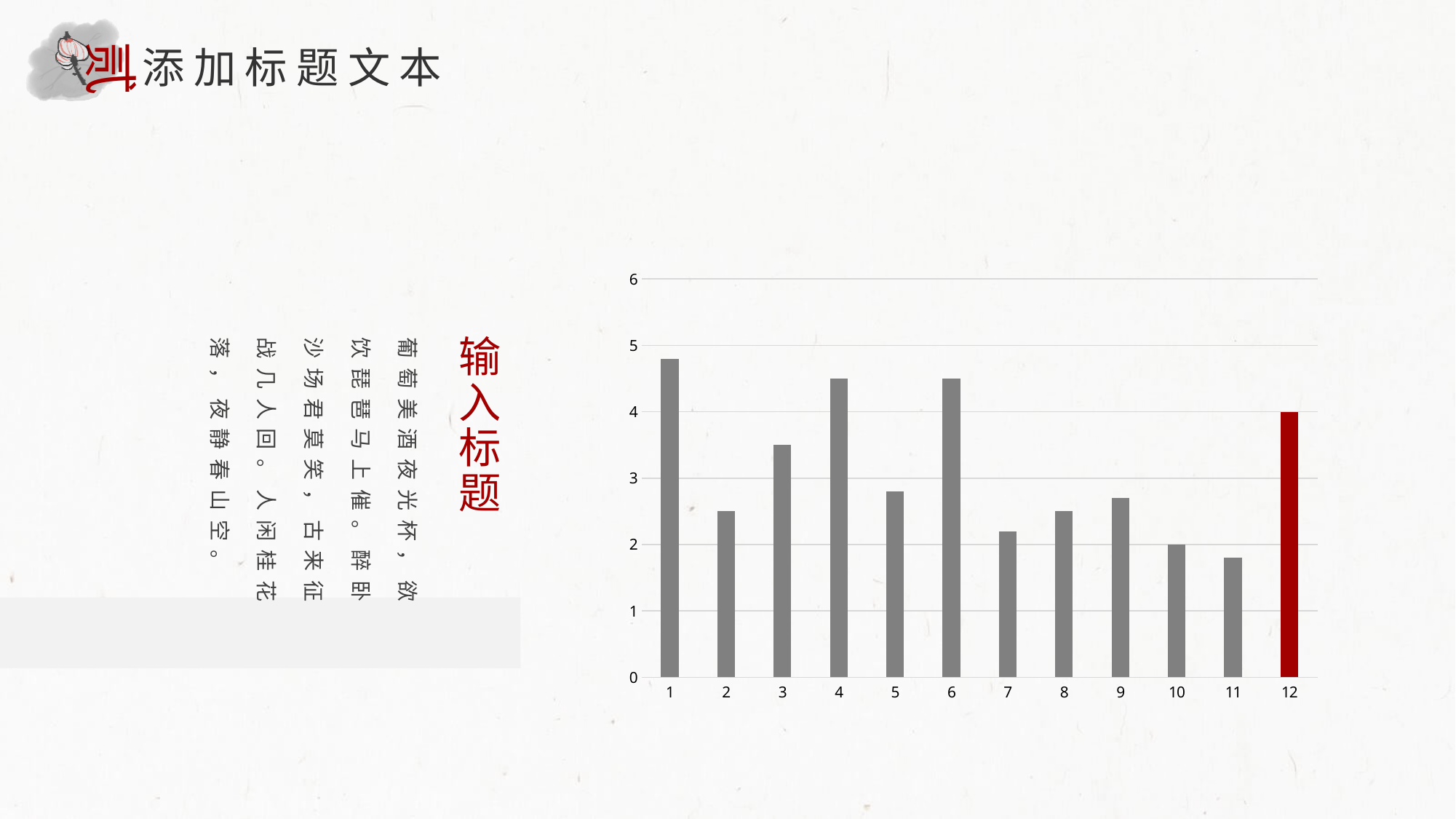
Which is larger, the value for category 9 or the value for category 12? 12 What is the value for category 10 in the chart? 2 What kind of chart is shown on the slide? bar chart Which bar in the chart is coloured red rather than grey? 12 Which is larger, the value for category 4 or the value for category 5? 4 Is the value for category 7 greater or less than 3? less Which category has the lowest bar in the chart? 11 Is the value for category 3 greater or less than 3? greater Is the value for category 1 greater or less than 4? greater What is the value for category 12 in the chart? 4 How many categories are shown on the x axis of the chart? 12 Which category has the highest bar in the chart? 1